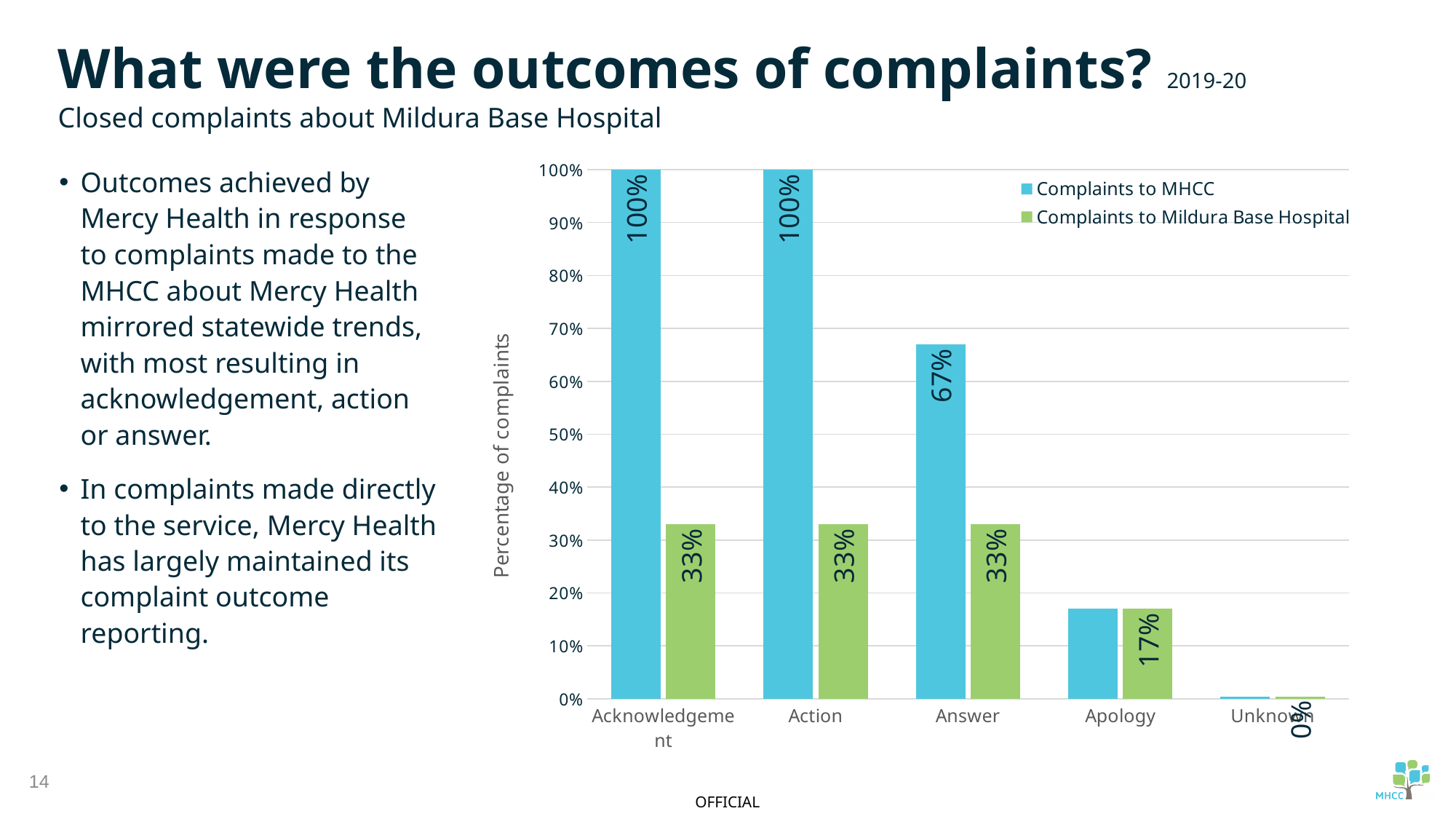
What is the value for Complaints to Mildura Base Hospital in the Answer category? 33% What kind of chart is shown on the slide? bar chart What is the value for Complaints to MHCC in the Answer category? 67% What is the value for Complaints to MHCC in the Acknowledgement category? 100% What is the title of the y axis? Percentage of complaints What is the difference between Complaints to MHCC and Complaints to Mildura Base Hospital in the Answer category? 34 percentage points In the Action category, which series has the larger value: Complaints to MHCC or Complaints to Mildura Base Hospital? Complaints to MHCC Is the value for Complaints to MHCC in the Apology category greater or less than 20%? less How many categories are shown on the x axis? 5 What is the value for Complaints to Mildura Base Hospital in the Apology category? 17% How many series does the legend list? 2 Which category has the lowest value for Complaints to Mildura Base Hospital? Unknown